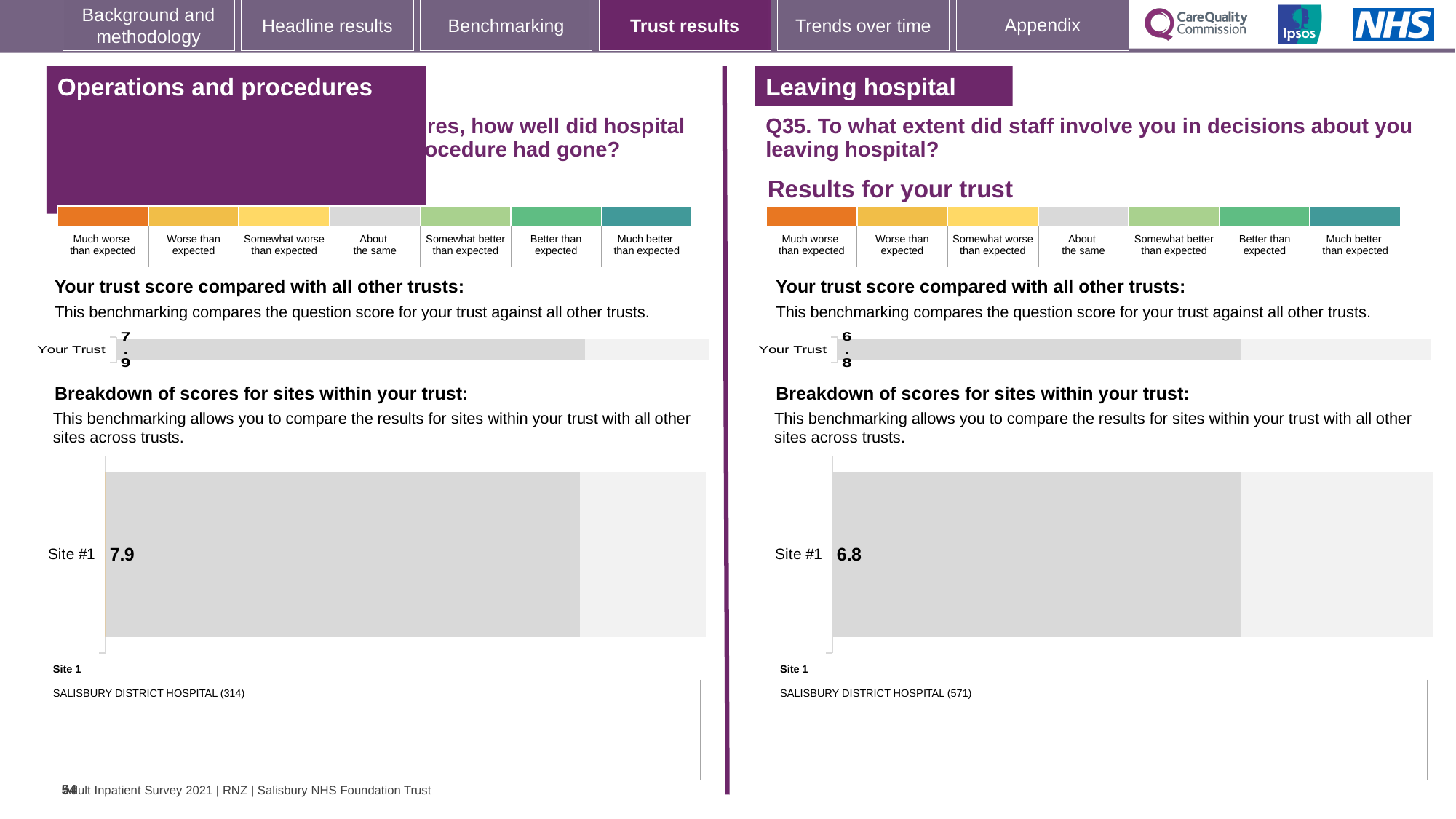
Which hospital is listed as Site 1 on the Leaving hospital side of the slide? SALISBURY DISTRICT HOSPITAL What is the difference between the Your Trust score on the Operations and procedures chart and the Your Trust score on the Leaving hospital chart? 1.1 How many sites are shown in the Operations and procedures breakdown of scores for sites chart? 1 On the Operations and procedures breakdown of scores for sites chart, what is the score for Site #1? 7.9 What kind of chart is used to show the Site #1 score on the Leaving hospital side of the slide? Bar chart On the Operations and procedures chart, what is the score shown for Your Trust? 7.9 How many rating categories are shown in the colour scale above the Leaving hospital charts? 7 On the Leaving hospital breakdown of scores for sites chart, what is the score for Site #1? 6.8 On the Leaving hospital (Q35) chart, what is the score shown for Your Trust? 6.8 Which has the higher Your Trust score: the Operations and procedures chart or the Leaving hospital chart? Operations and procedures How many sites are shown in the Leaving hospital breakdown of scores for sites chart? 1